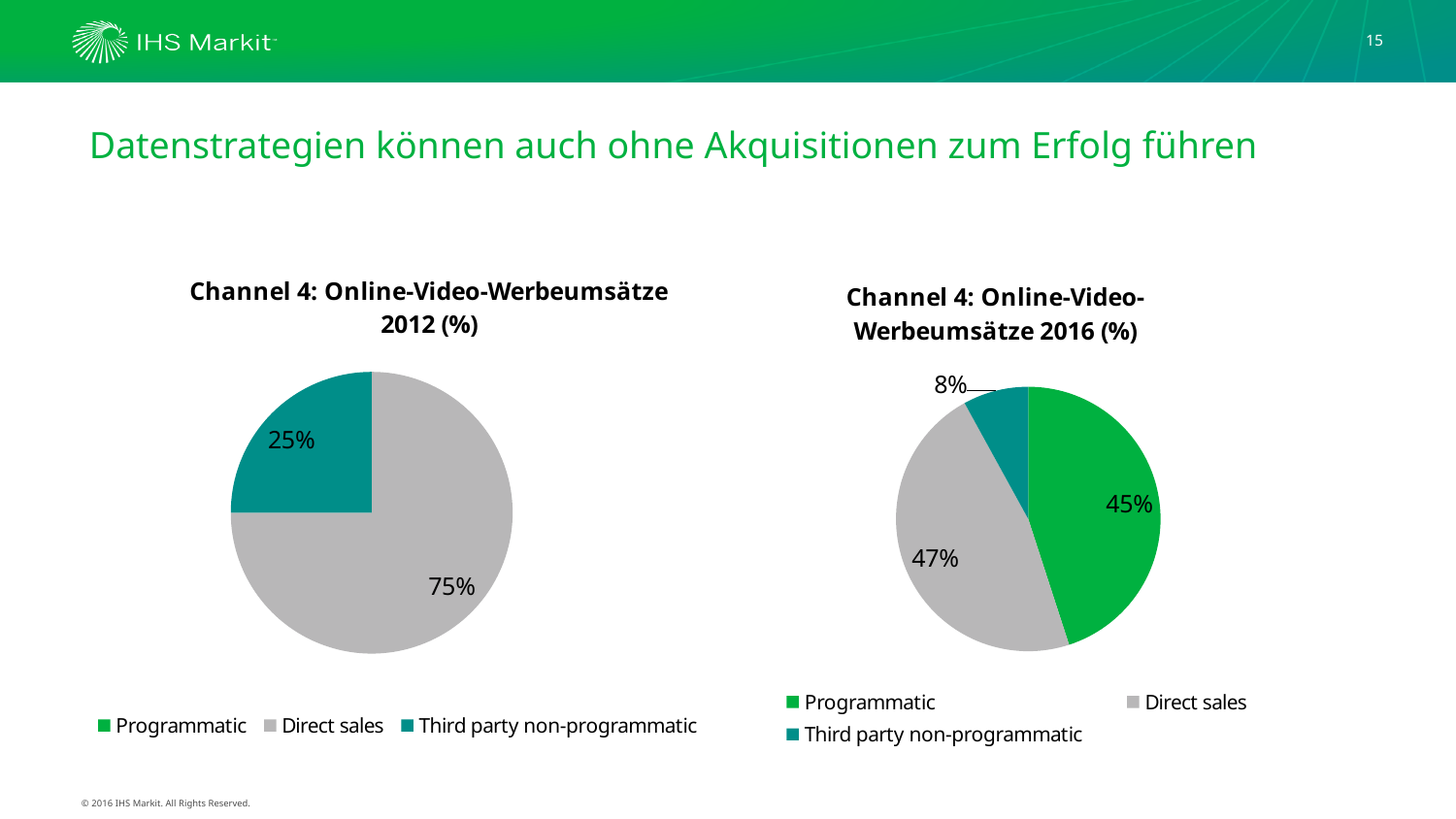
What type of chart is used on the slide for the 2016 data? Pie chart In the 2012 chart, which category has the largest slice? Direct sales In the 2012 chart, how much larger is the Direct sales share than the Third party non-programmatic share? 50% In the 2012 chart, what share is labelled for Third party non-programmatic? 25% In the 2016 chart, is the Programmatic share larger or smaller than the Third party non-programmatic share? larger In the 2016 chart, what share is shown for Direct sales? 47% How many entries does the legend of the 2016 chart list? 3 In the 2012 chart, what share of Channel 4's online video advertising revenue came from Direct sales? 75% In the 2016 chart, what share is shown for Programmatic? 45% In the 2016 chart, which category has the smallest slice? Third party non-programmatic In the 2016 chart, what is the difference between the Direct sales share and the Programmatic share? 2% In the 2016 chart, what share is shown for Third party non-programmatic? 8%